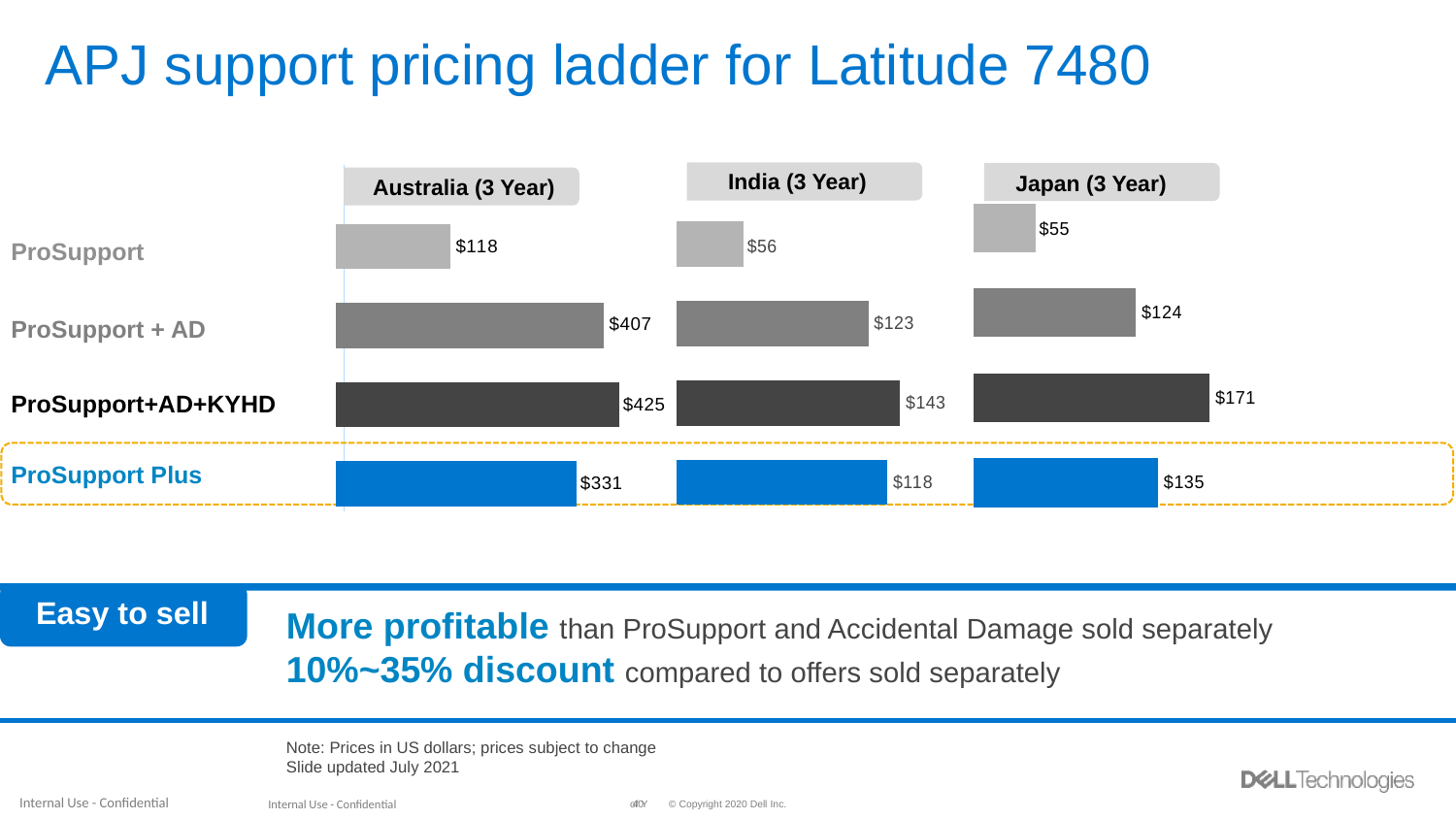
In the Australia (3 Year) chart, what is the price for ProSupport Plus? $331 In the Australia (3 Year) chart, what is the difference between the ProSupport+AD+KYHD price and the ProSupport Plus price? $94 In the Japan (3 Year) chart, what is the price for ProSupport+AD+KYHD? $171 In the India (3 Year) chart, what is the difference between the ProSupport Plus price and the ProSupport price? $62 In the India (3 Year) chart, what is the price for ProSupport + AD? $123 In the Australia (3 Year) chart, which support tier has the highest price? ProSupport+AD+KYHD In the Japan (3 Year) chart, which support tier has the lowest price? ProSupport What kind of chart is used to show the India (3 Year) pricing? Bar chart Which is larger: the ProSupport Plus price in the India (3 Year) chart or in the Japan (3 Year) chart? Japan (3 Year) In the Japan (3 Year) chart, which is larger: the price for ProSupport + AD or the price for ProSupport Plus? ProSupport Plus How many support tiers are shown in the Australia (3 Year) chart? 4 Which support tier is highlighted with a dashed outline across all three charts? ProSupport Plus